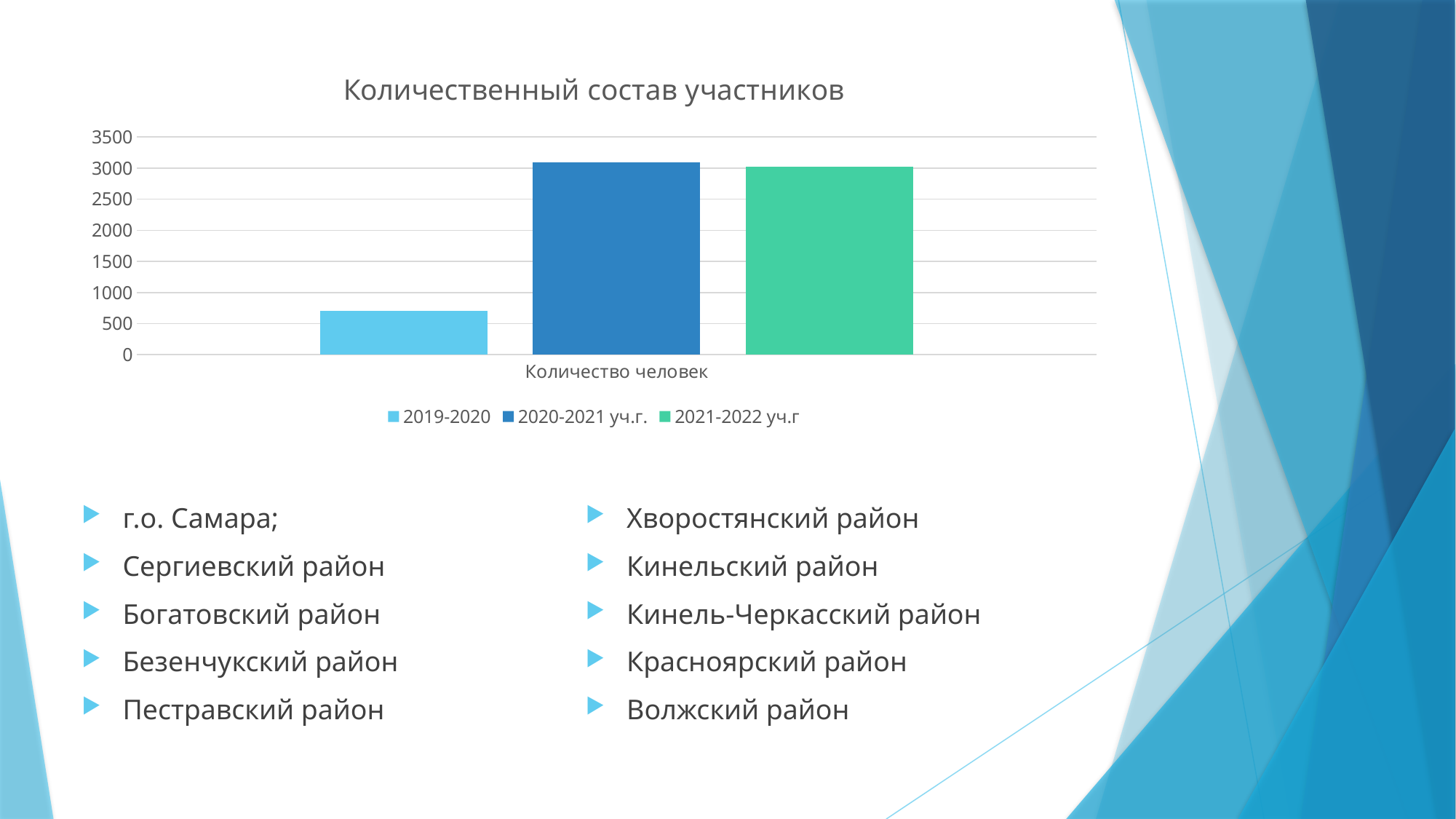
What kind of chart is shown on the slide? bar chart Is the value for 2021-2022 уч.г greater or less than 3500? less Which series has the lowest value in the chart? 2019-2020 Which is larger, the value for 2019-2020 or the value for 2021-2022 уч.г? 2021-2022 уч.г Is the value for 2020-2021 уч.г. greater or less than 3000? greater How many series does the chart legend list? 3 What is the label of the category on the x axis? Количество человек Is the value for 2019-2020 greater or less than 1000? less How many categories are shown on the x axis of the chart? 1 Which series has the highest value in the chart? 2020-2021 уч.г. What is the title of the chart? Количественный состав участников